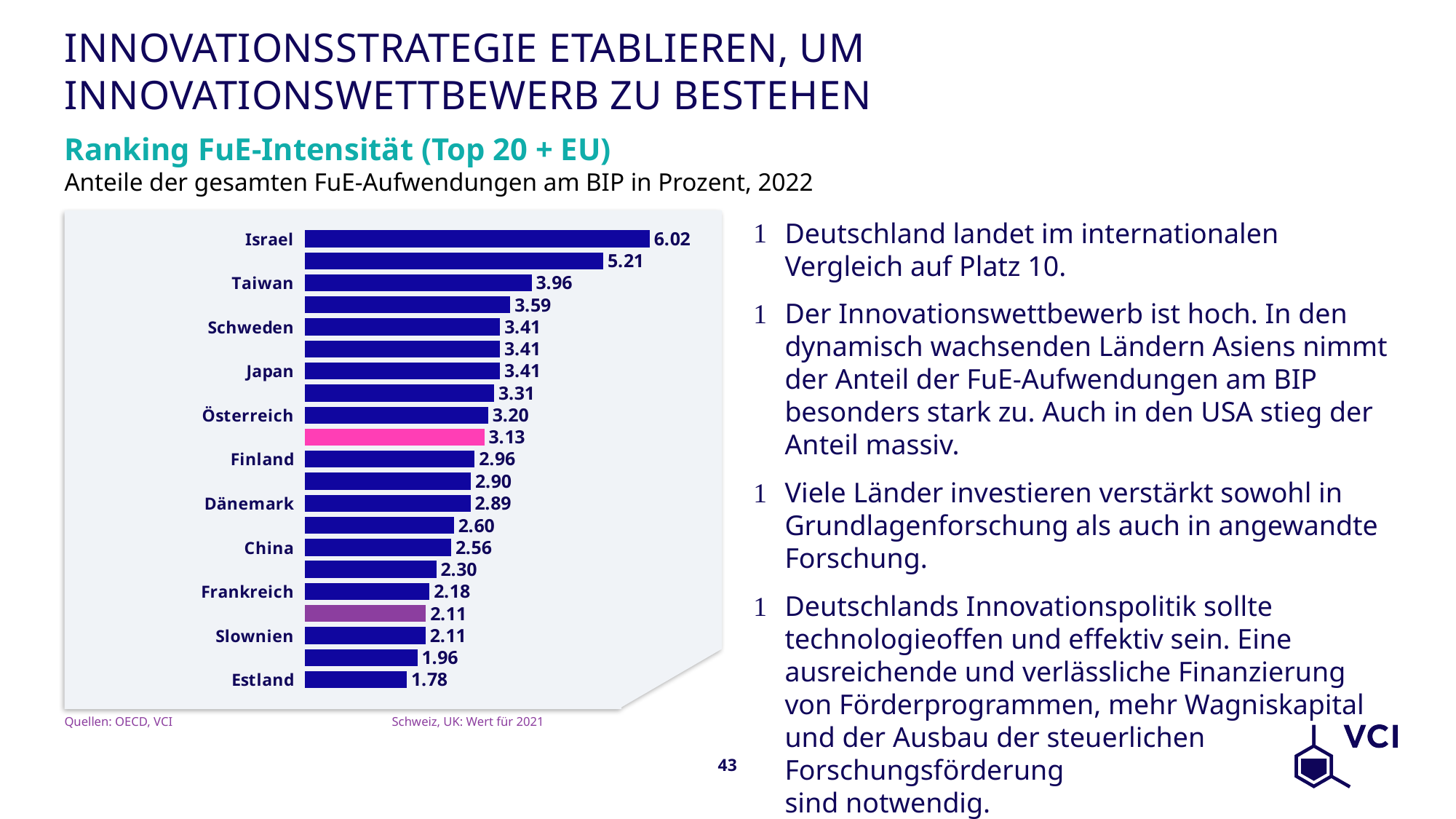
What is the value for Estland? 1.78 What value is labelled on the pink highlighted bar? 3.13 Which country has the lowest value in the chart? Estland What kind of chart is shown on the slide? Bar chart How many bars are shown in the chart? 21 What is the value for Taiwan? 3.96 What is the value shown for China? 2.56 What is the value for Israel in the chart? 6.02 What is the difference between the values for Taiwan and Japan? 0.55 What is the difference between the values for Israel and Estland? 4.24 Which country has the highest FuE-Intensität in the chart? Israel Which has the larger value, Finland or Dänemark? Finland